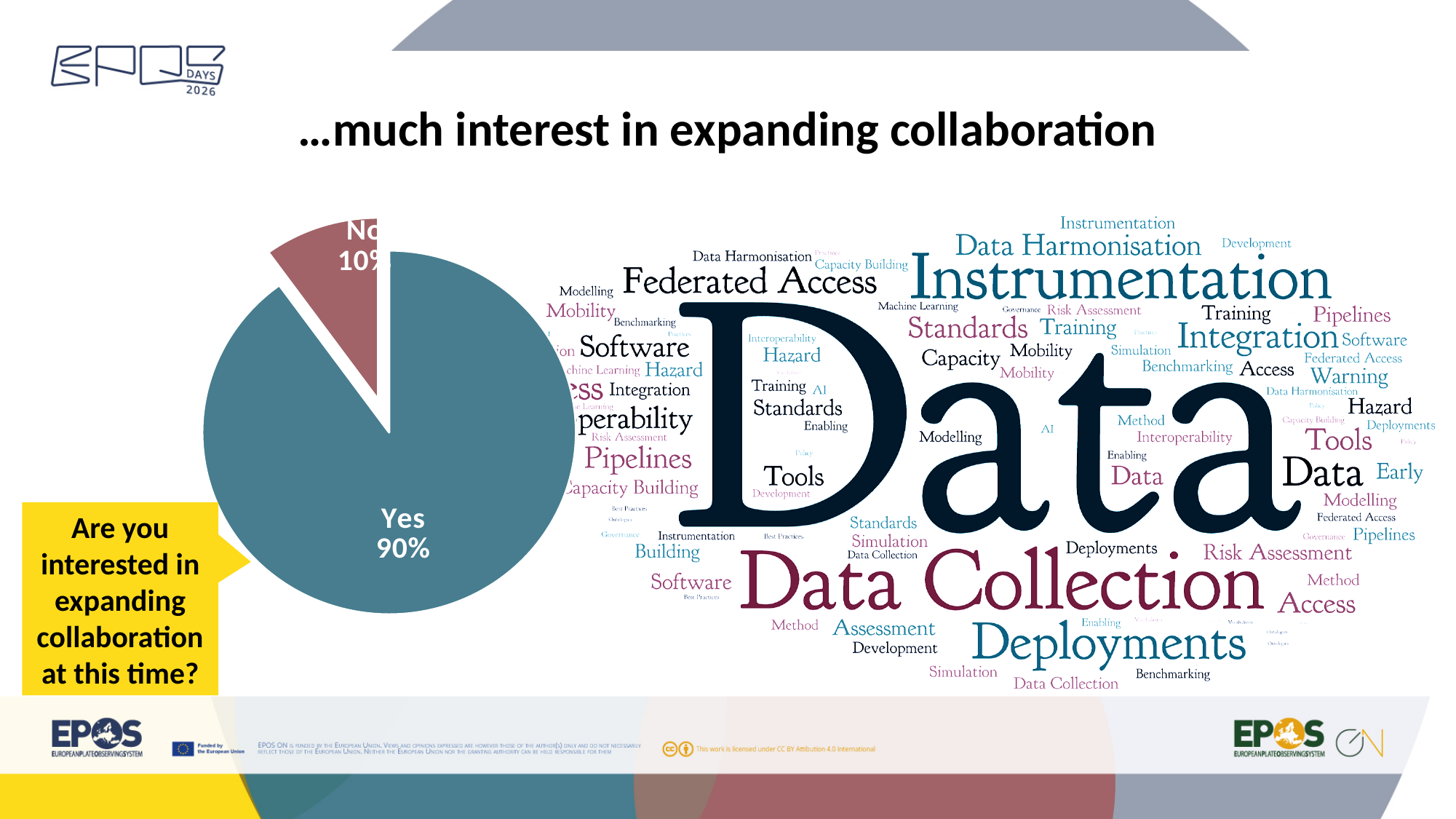
Which slice of the pie chart is the smallest? No What percentage of respondents answered "Yes" in the pie chart? 90% What percentage of respondents answered "No" in the pie chart? 10% What share of the pie does the "Yes" slice represent? 90% What kind of chart is shown on the left of the slide? pie chart How many slices does the pie chart have? 2 What question does the pie chart answer, according to the yellow callout on the slide? Are you interested in expanding collaboration at this time? What colour is the "No" slice of the pie chart? red What is the difference in percentage points between the "Yes" and "No" slices of the pie chart? 80 Which is larger in the pie chart, the "Yes" slice or the "No" slice? Yes Which slice of the pie chart is the largest? Yes